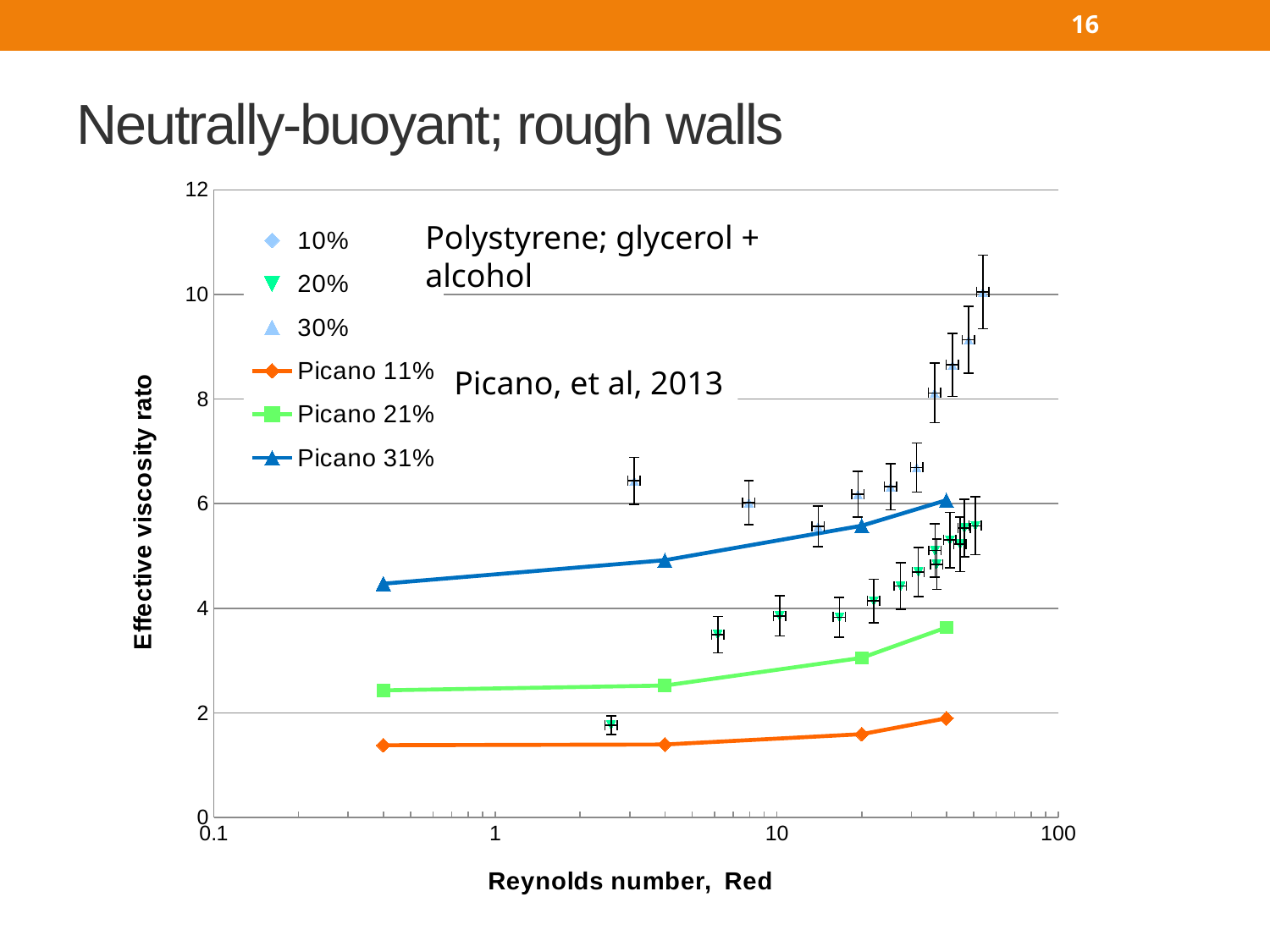
At the rightmost point, which is larger: the Picano 21% line or the Picano 11% line? Picano 21% What is the title of the y axis? Effective viscosity rato How many data points are plotted on the Picano 11% line? 4 Which of the three Picano lines has the highest effective viscosity ratio values? Picano 31% Is the value of the Picano 31% line at its leftmost point greater or less than 4? greater Does the Picano 31% line rise or fall as the Reynolds number increases? rise What kind of chart is shown on the slide? line chart Which of the three Picano lines has the lowest effective viscosity ratio values? Picano 11% How many series does the chart legend list? 6 Is the value of the Picano 21% line at its rightmost point greater or less than 4? less What is the title of the x axis? Reynolds number, Red